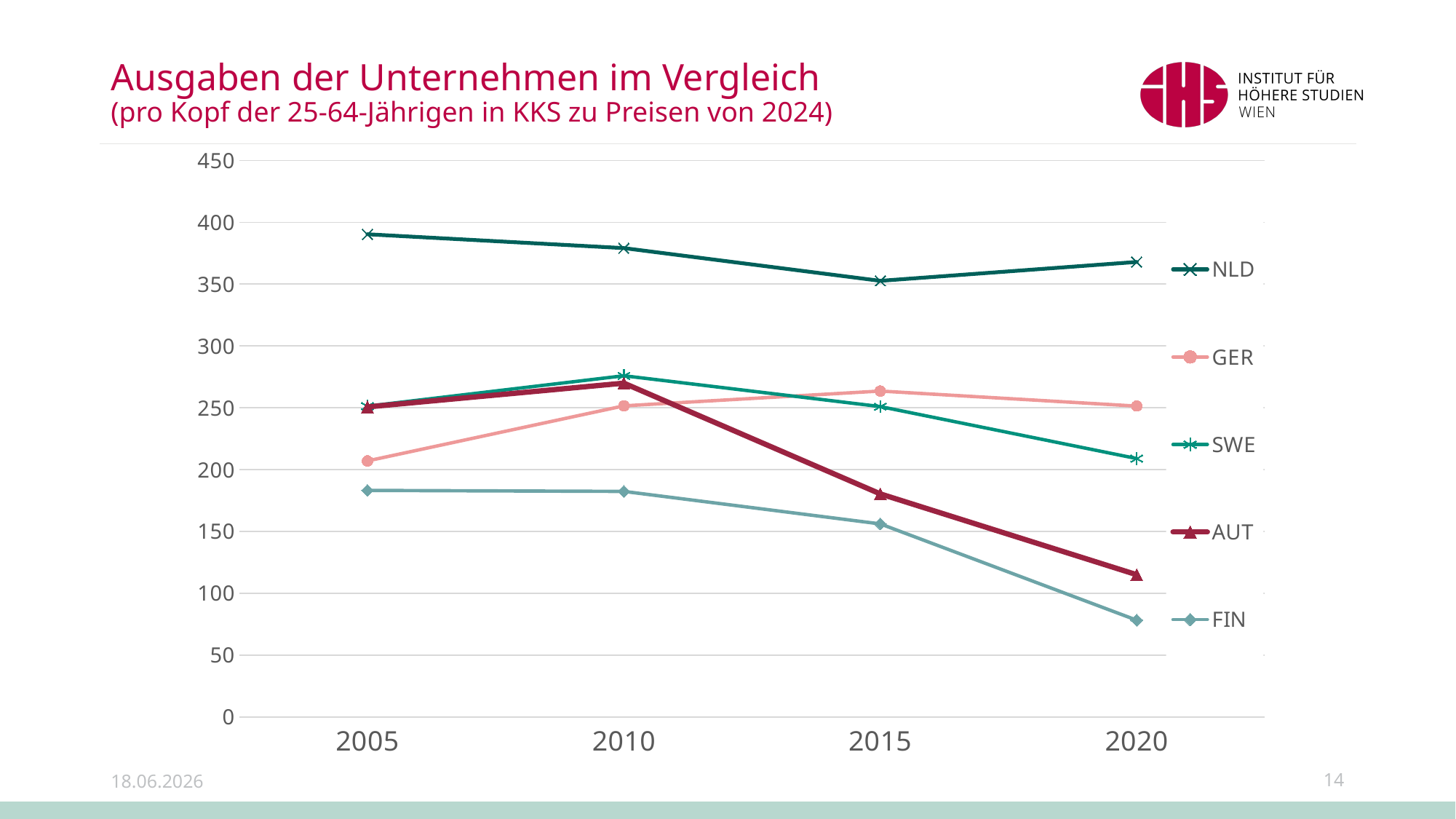
What kind of chart is shown on the slide? line chart Is the value for AUT in 2020 greater or less than 150? less Is the value for GER in 2005 greater or less than 250? less Which country has the lowest value in 2020? FIN Is the value for FIN in 2020 greater or less than 100? less Does the value for AUT rise or fall from 2010 to 2020? fall What is the title of the chart? Ausgaben der Unternehmen im Vergleich How many series does the legend list? 5 How many years are shown on the x axis? 4 Which country has the highest value in 2020? NLD In 2020, which is larger, the value for GER or the value for SWE? GER